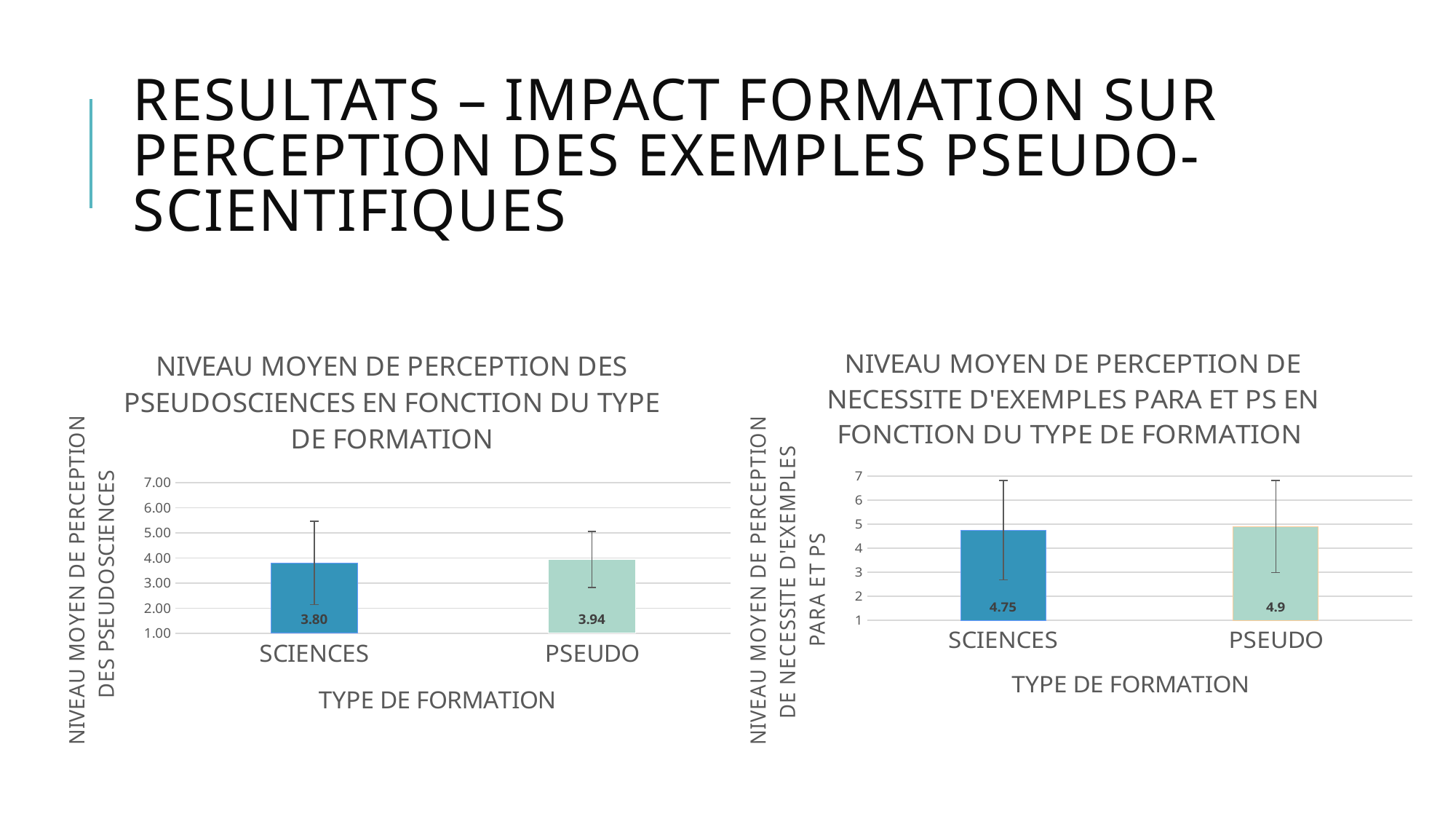
How many categories are shown on the x axis of the left chart? 2 In the right chart, what is the value for SCIENCES? 4.75 In the left chart, what is the value for SCIENCES? 3.80 In the left chart, what is the value for PSEUDO? 3.94 In the left chart, which category has the higher value, SCIENCES or PSEUDO? PSEUDO In the right chart, what is the value for PSEUDO? 4.9 In the right chart, which category has the lowest value? SCIENCES In the left chart, what is the difference between the PSEUDO and SCIENCES values? 0.14 What is the x-axis title of the left chart? TYPE DE FORMATION What kind of chart is the right chart? bar chart In the right chart, what is the difference between the PSEUDO and SCIENCES values? 0.15 In the right chart, is the value for SCIENCES greater or less than 4? greater